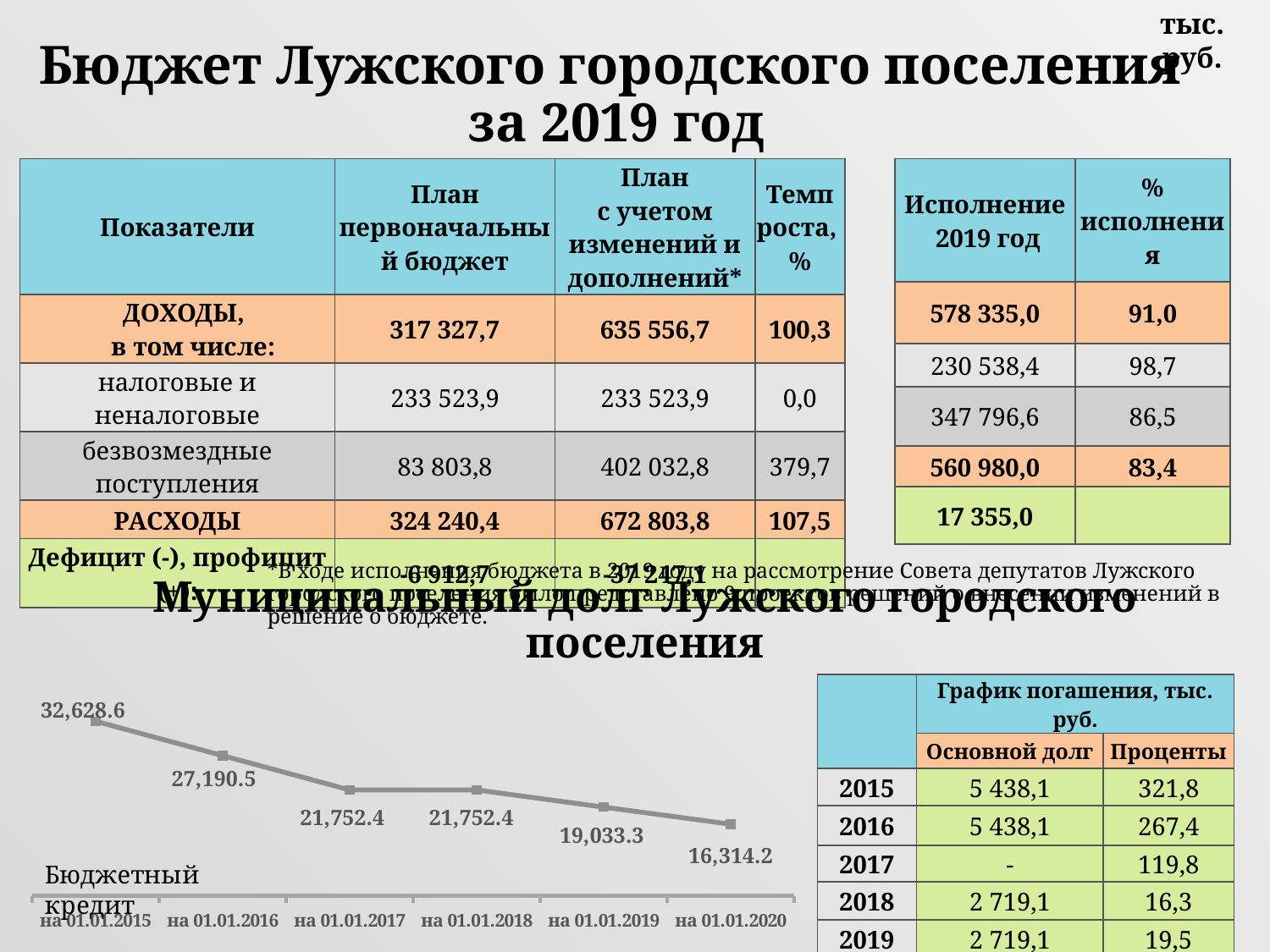
In the line chart, what is the value for на 01.01.2015? 32,628.6 In the line chart, what is the value for на 01.01.2020? 16,314.2 In the line chart, which date has the highest value? на 01.01.2015 In the line chart, what is the value for на 01.01.2018? 21,752.4 How many data points are plotted in the line chart? 6 In the line chart, which is larger: the value for на 01.01.2016 or the value for на 01.01.2019? на 01.01.2016 In the line chart, what is the difference between the values for на 01.01.2019 and на 01.01.2020? 2,719.1 What type of chart is shown at the bottom left of the slide? line chart In the line chart, what is the value for на 01.01.2019? 19,033.3 Do the values in the line chart rise or fall from на 01.01.2015 to на 01.01.2020? fall In the line chart, what is the difference between the values for на 01.01.2015 and на 01.01.2016? 5,438.1 In the line chart, which date has the lowest value? на 01.01.2020